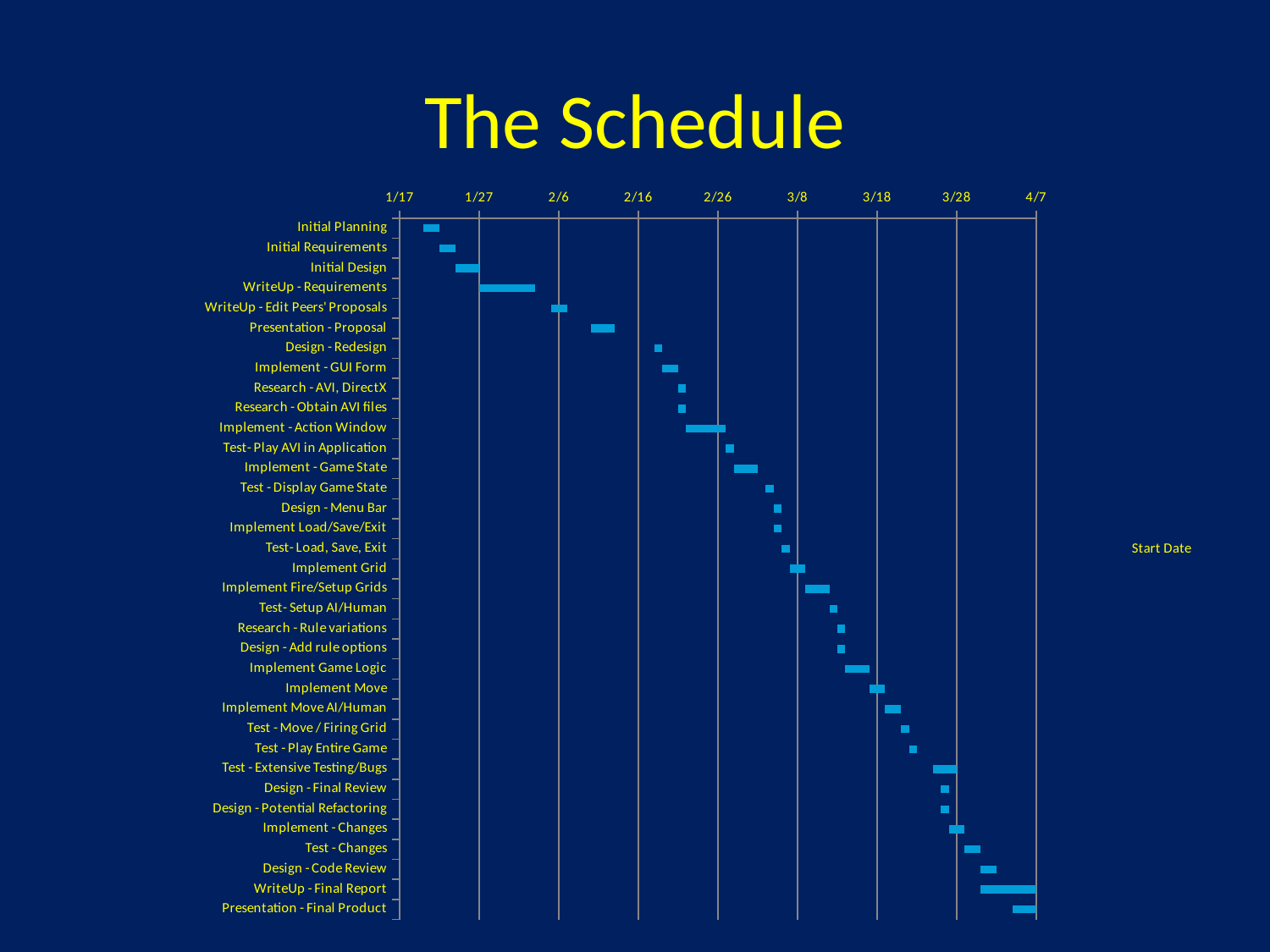
Does the bar for WriteUp - Final Report start before or after 3/28? after How many tasks are listed on the vertical axis of the chart? 35 What is the title of the slide? The Schedule How many series does the legend list? 1 Going down the task list, do the start dates get later or earlier? later What kind of chart is shown on the slide? bar chart Does the bar for WriteUp - Requirements start before or after 2/6? before What is the legend entry shown on the chart? Start Date Which task starts later, Test - Changes or Design - Code Review? Design - Code Review Does the bar for Implement Game Logic start before or after 3/18? before Which task starts earlier, Initial Planning or Initial Design? Initial Planning